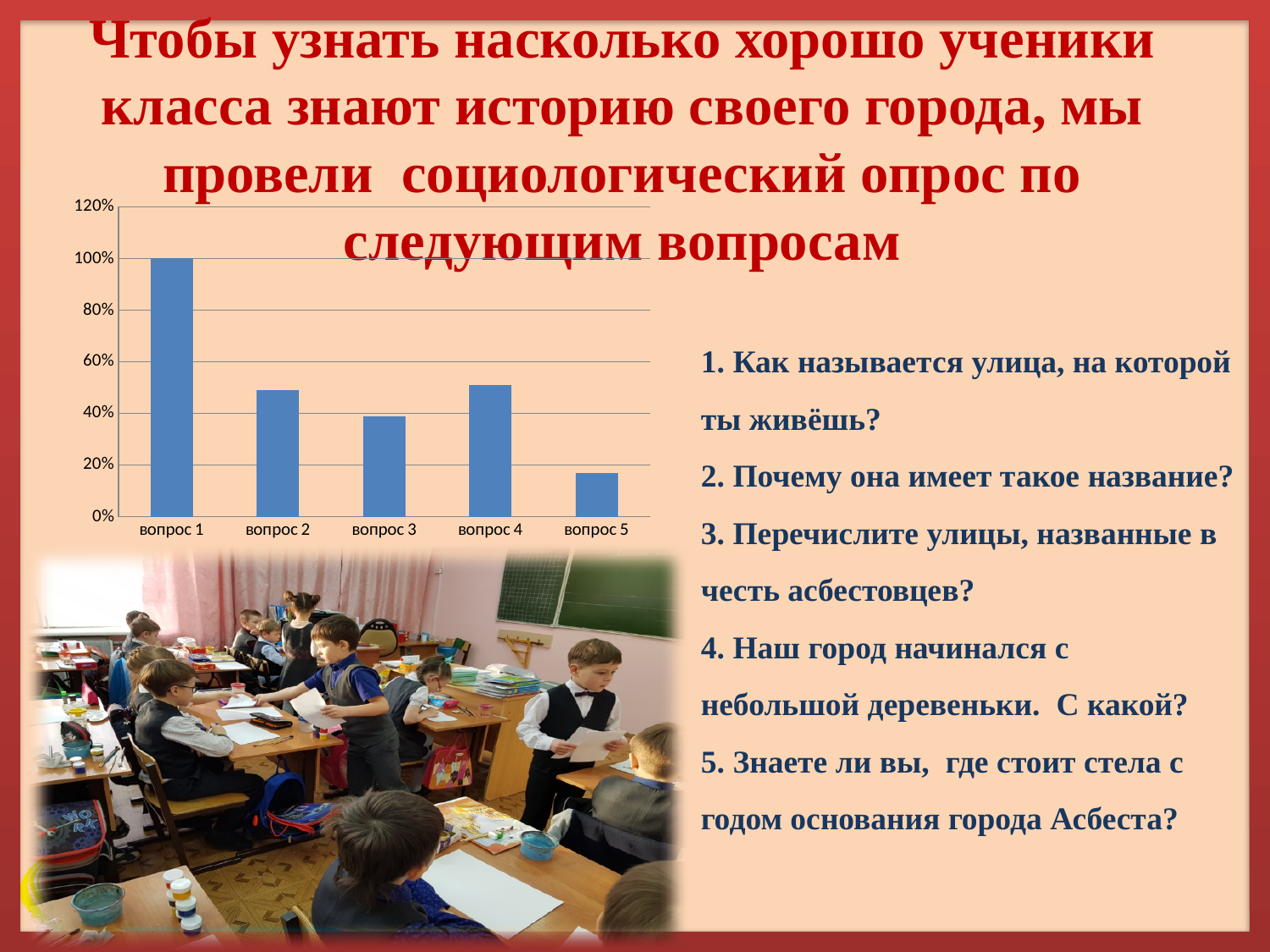
How many categories (questions) are shown on the x axis of the chart? 5 Which is larger, the value for вопрос 2 or the value for вопрос 3? вопрос 2 What type of chart is shown on the slide? bar chart Is the value for вопрос 5 greater or less than 20%? less What is the value for вопрос 1 in the chart? 100% What is the highest value shown on the y axis of the chart? 120% Is the value for вопрос 4 greater or less than 40%? greater Which is larger, the value for вопрос 1 or the value for вопрос 4? вопрос 1 Is the value for вопрос 2 greater or less than 40%? greater Which category has the lowest bar in the chart? вопрос 5 Which category has the highest bar in the chart? вопрос 1